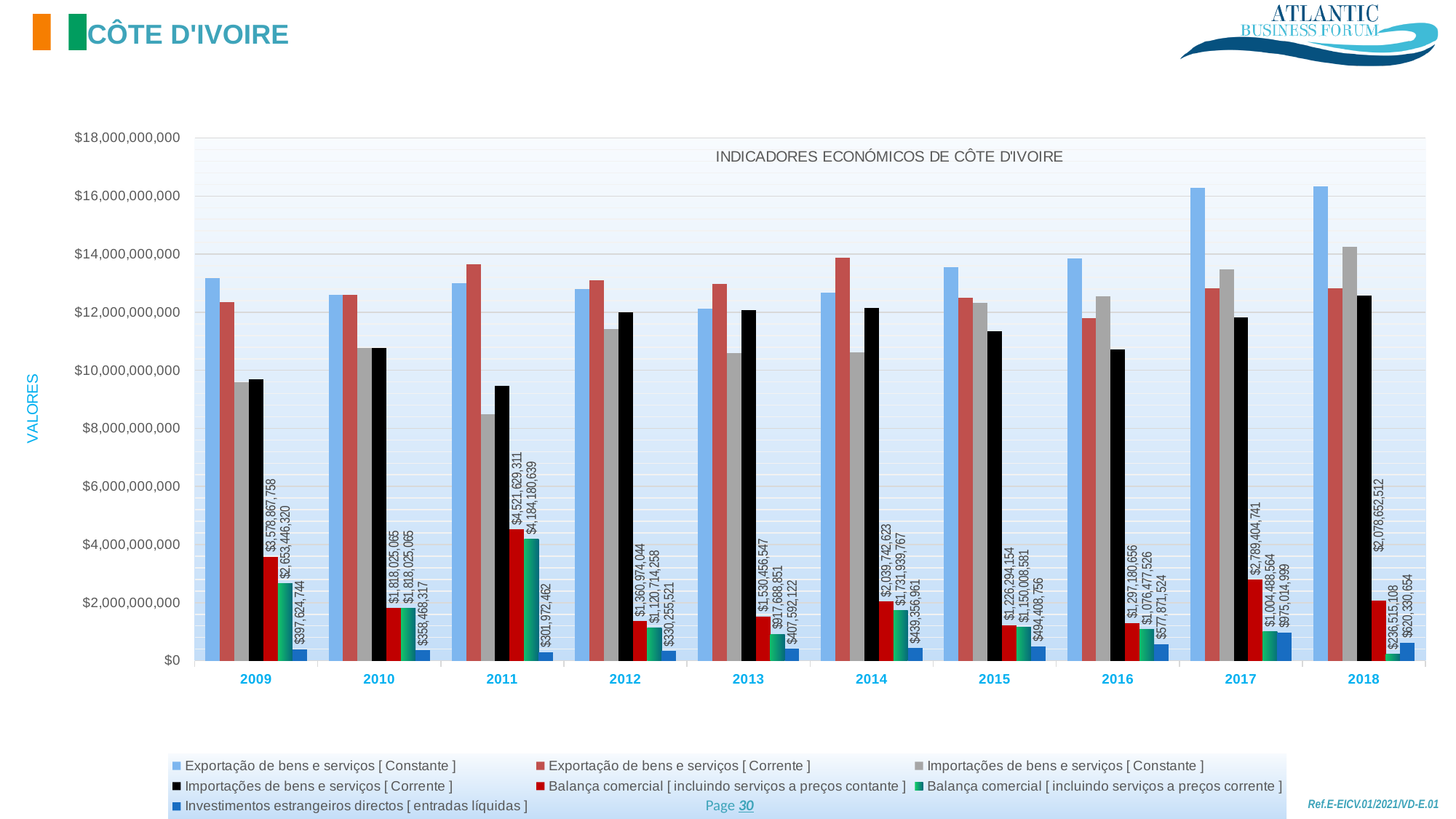
How many years are shown on the x axis? 10 In 2014, which is larger: Exportação de bens e serviços [ Corrente ] or Importações de bens e serviços [ Corrente ]? Exportação de bens e serviços [ Corrente ] In which year is Investimentos estrangeiros directos [ entradas líquidas ] highest? 2017 What is the difference between Balança comercial [ incluindo serviços a preços contante ] and Balança comercial [ incluindo serviços a preços corrente ] in 2009? $925,421,438 What is the value of Investimentos estrangeiros directos [ entradas líquidas ] in 2017? $975,014,999 Is the value for Exportação de bens e serviços [ Constante ] in 2017 greater or less than $16,000,000,000? greater What kind of chart is shown on the slide? bar chart What is the title of the chart? INDICADORES ECONÓMICOS DE CÔTE D'IVOIRE What is the value of Balança comercial [ incluindo serviços a preços corrente ] in 2013? $917,688,851 What is the value of Balança comercial [ incluindo serviços a preços contante ] in 2011? $4,521,629,311 How many series does the legend list? 7 In which year is Balança comercial [ incluindo serviços a preços corrente ] lowest? 2018